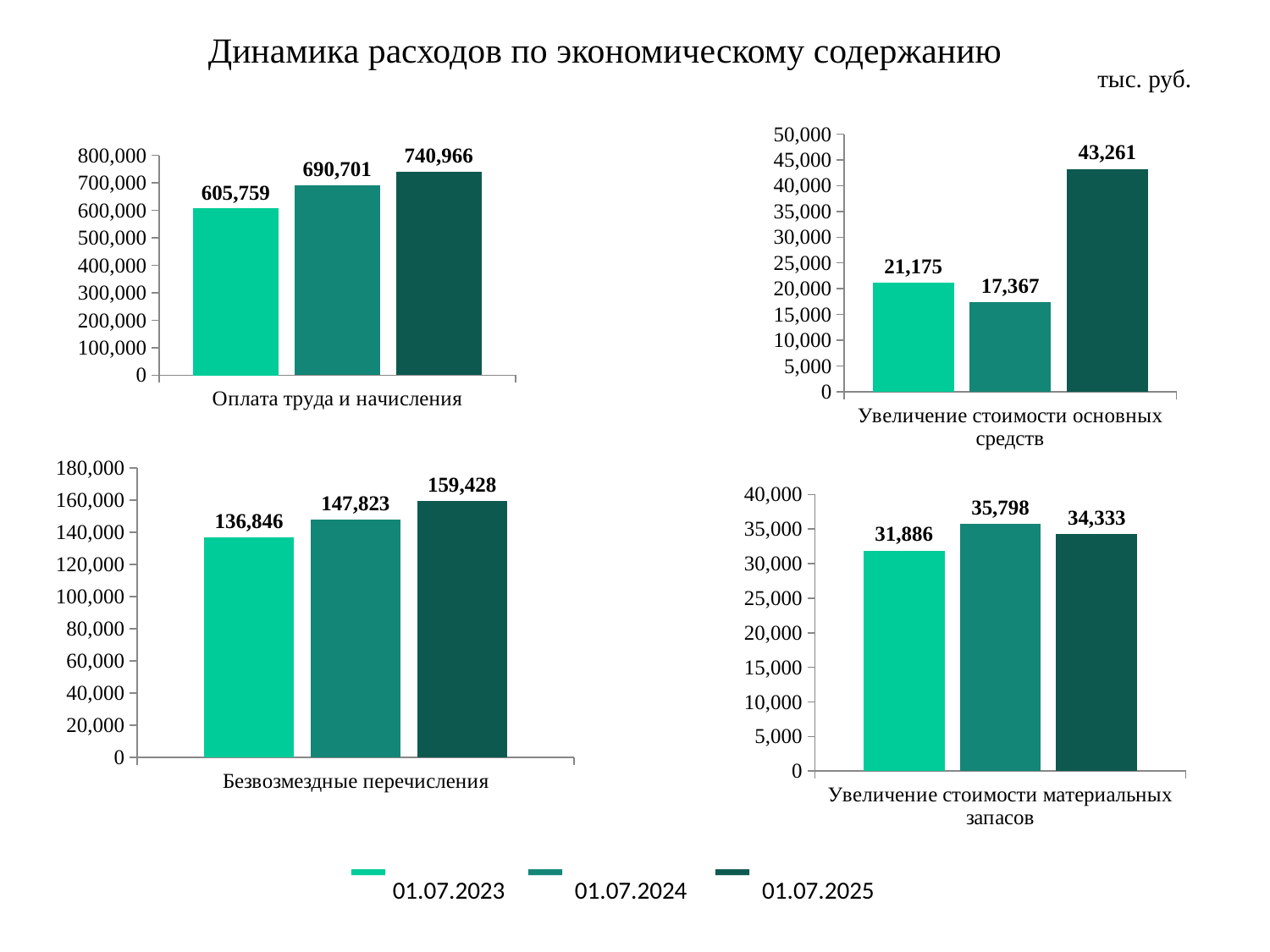
In the chart "Оплата труда и начисления", what is the difference between the values for 01.07.2025 and 01.07.2023? 135,207 In the chart "Увеличение стоимости материальных запасов", which date has the highest value? 01.07.2024 In the chart "Увеличение стоимости основных средств", which date has the lowest value? 01.07.2024 In the chart "Увеличение стоимости основных средств", what is the value for 01.07.2024? 17,367 How many series does the legend at the bottom of the slide list? 3 In the chart "Увеличение стоимости материальных запасов", which is larger: the value for 01.07.2024 or for 01.07.2025? 01.07.2024 In the chart "Безвозмездные перечисления", do the values rise or fall from 01.07.2023 to 01.07.2025? rise In the chart "Оплата труда и начисления", what is the value for 01.07.2025? 740,966 In the chart "Увеличение стоимости основных средств", what is the difference between the values for 01.07.2025 and 01.07.2024? 25,894 In the chart "Безвозмездные перечисления", what is the value for 01.07.2023? 136,846 What kind of chart is "Оплата труда и начисления"? bar chart In the chart "Безвозмездные перечисления", is the value for 01.07.2025 greater or less than 140,000? greater